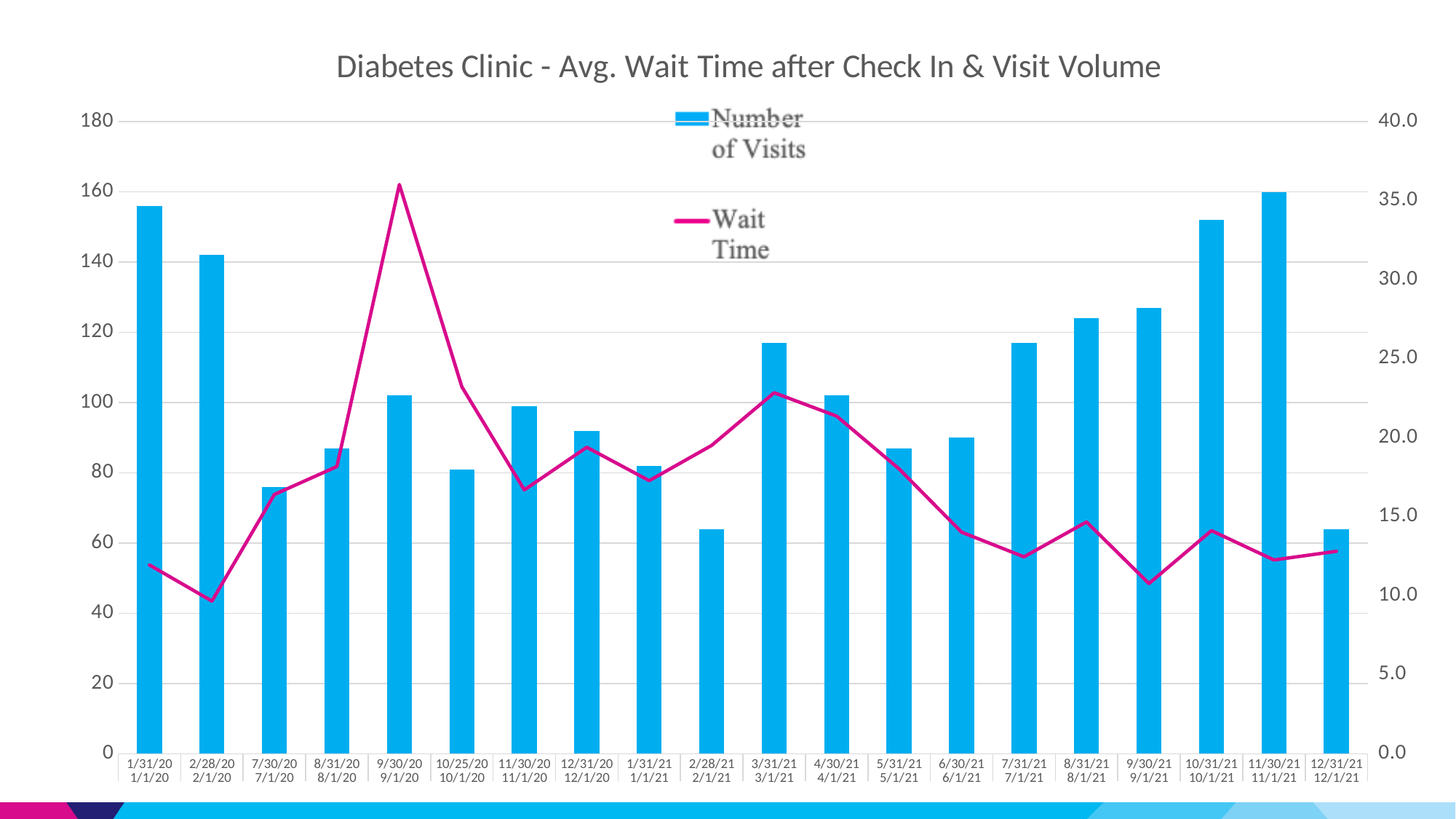
Is the Number of Visits for 2/28/21 greater or less than 80? less Which date has the highest Wait Time? 9/30/20 Is the Wait Time for 9/30/20 greater or less than 30.0? greater Which series is drawn as a line rather than bars? Wait Time Does the Wait Time rise or fall from 9/30/20 to 11/30/20? fall What is the title of the chart? Diabetes Clinic - Avg. Wait Time after Check In & Visit Volume How many date categories are shown on the x axis? 20 Is the Number of Visits for 1/31/20 greater or less than 140? greater How many series does the legend list? 2 Which date has the lowest Wait Time? 2/28/20 Which has more visits, 3/31/21 or 4/30/21? 3/31/21